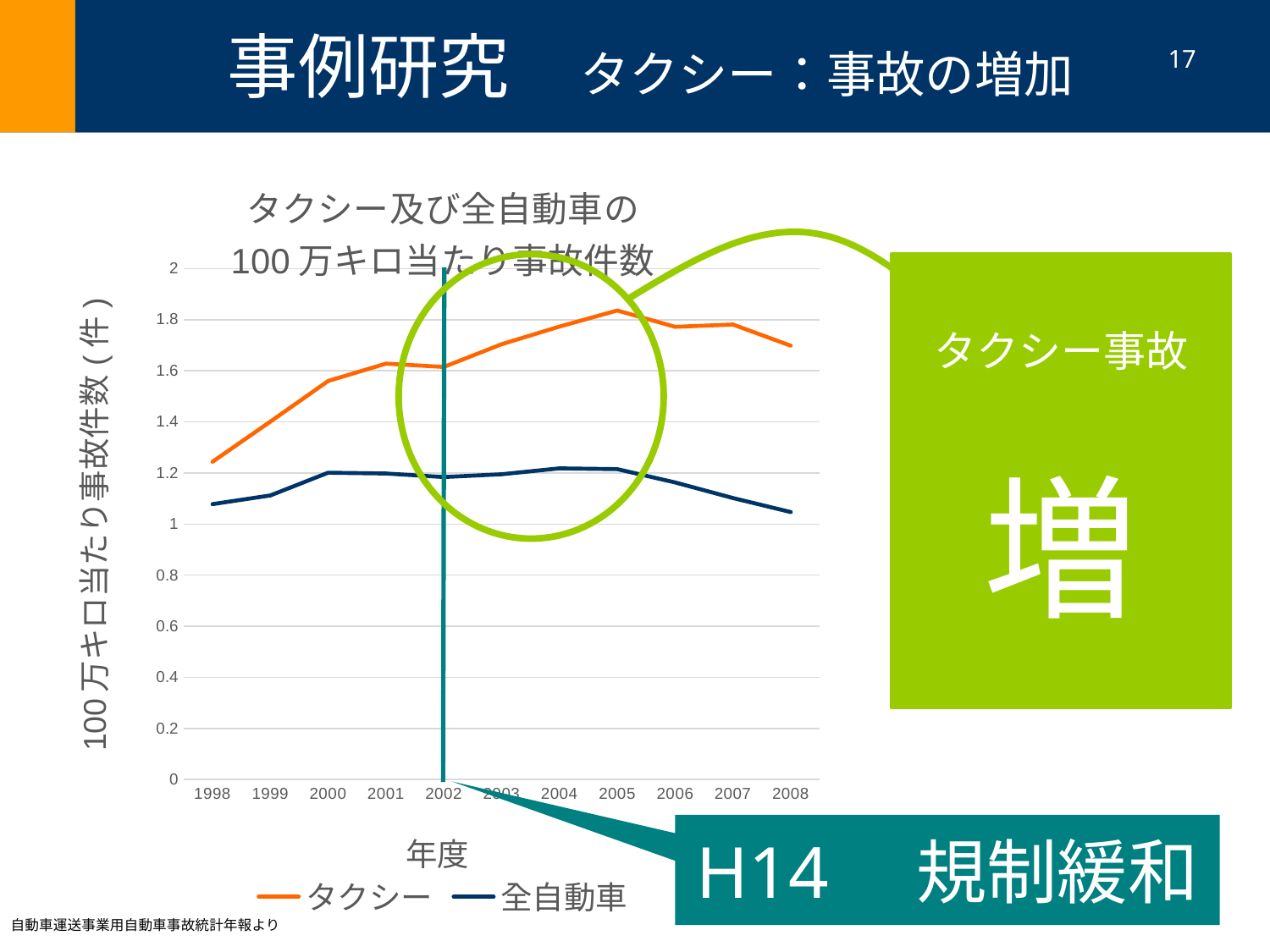
In which year does the タクシー series reach its highest value? 2005 In 2008, which series has the larger value, タクシー or 全自動車? タクシー How many series does the legend list? 2 Is the value for タクシー in 2005 greater or less than 1.6? greater Which colour is used for the タクシー series? orange How many years are plotted along the x axis? 11 What kind of chart is shown on the slide? line chart In which year is the タクシー series at its lowest value? 1998 Is the value for タクシー in 1998 greater or less than 1.4? less What is the title of the chart? タクシー及び全自動車の100万キロ当たり事故件数 Does the タクシー series rise or fall between 1998 and 2005? rise Is the value for 全自動車 in 2008 greater or less than 1.2? less